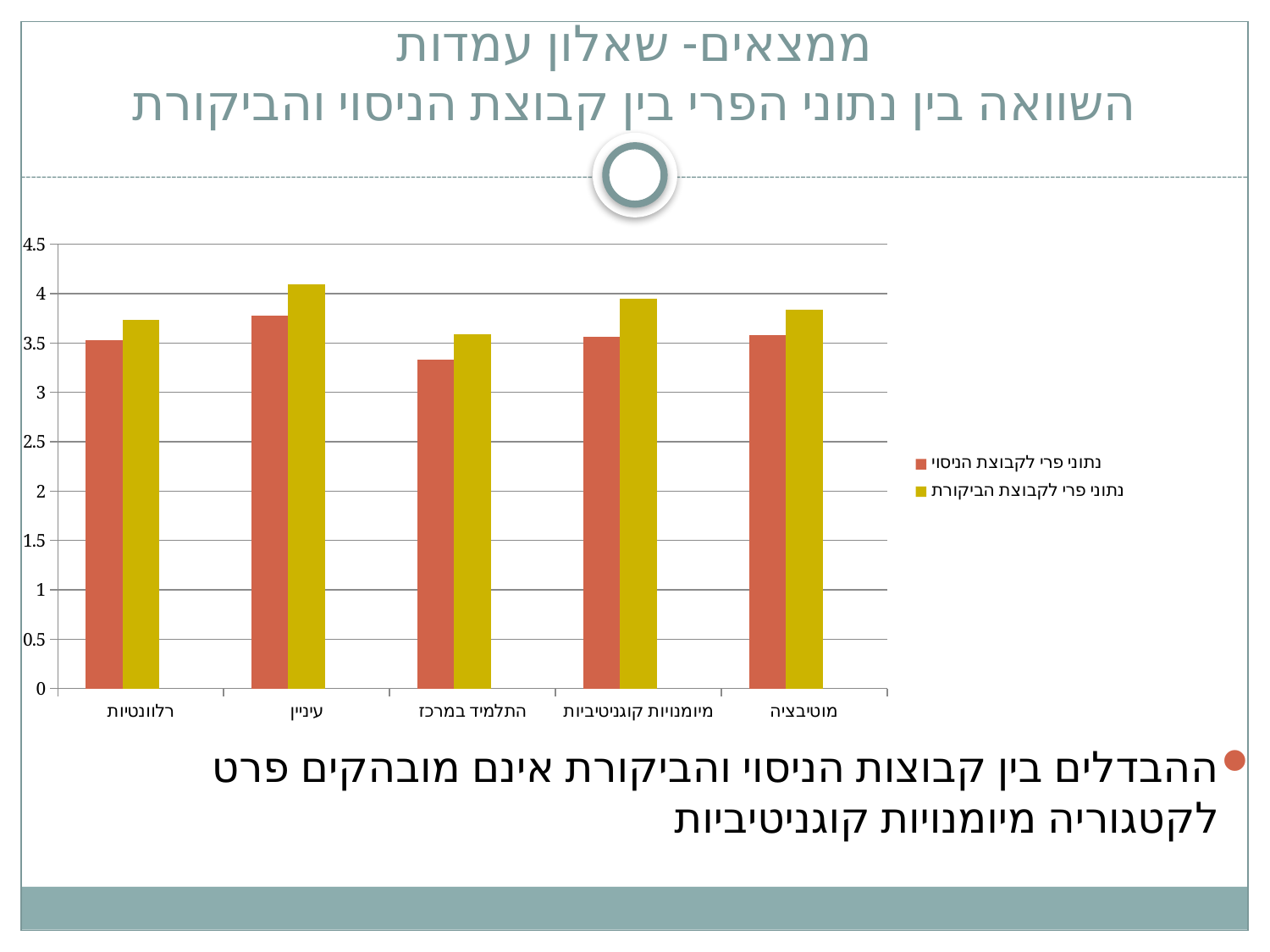
Is the value for עניין in the series נתוני פרי לקבוצת הביקורת greater or less than 4? greater What kind of chart is shown on the slide? bar chart For the category מיומנויות קוגניטיביות, which series has the larger value: נתוני פרי לקבוצת הניסוי or נתוני פרי לקבוצת הביקורת? נתוני פרי לקבוצת הביקורת Which category has the lowest value for the series נתוני פרי לקבוצת הניסוי? התלמיד במרכז Which colour represents the series נתוני פרי לקבוצת הביקורת in the chart? yellow How many categories are shown on the x axis of the chart? 5 Which category has the lowest value for the series נתוני פרי לקבוצת הביקורת? התלמיד במרכז How many series does the chart legend list? 2 Is the value for התלמיד במרכז in the series נתוני פרי לקבוצת הניסוי greater or less than 3.5? less Which category has the highest value for the series נתוני פרי לקבוצת הניסוי? עיניין Which category has the highest value for the series נתוני פרי לקבוצת הביקורת? עיניין